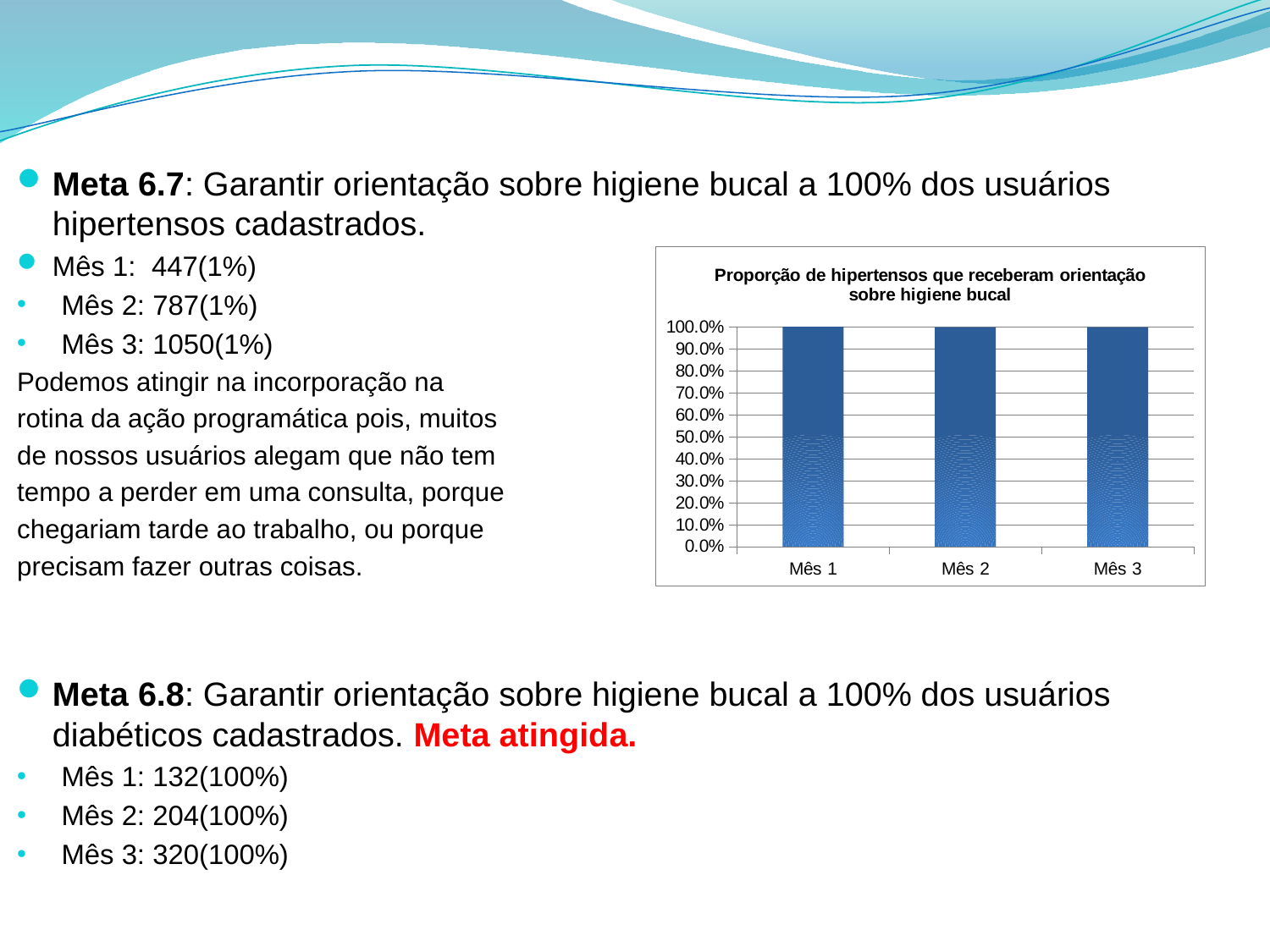
What value does the bar for Mês 1 reach on the y axis? 100.0% Is the value for Mês 1 greater or less than 50.0%? greater How many categories are plotted on the x axis of the chart? 3 What is the highest tick value shown on the y axis? 100.0% Is the value for Mês 3 greater or less than 90.0%? greater What kind of chart is shown on the slide? bar chart What is the title of the chart? Proporção de hipertensos que receberam orientação sobre higiene bucal What is the label of the first category on the x axis? Mês 1